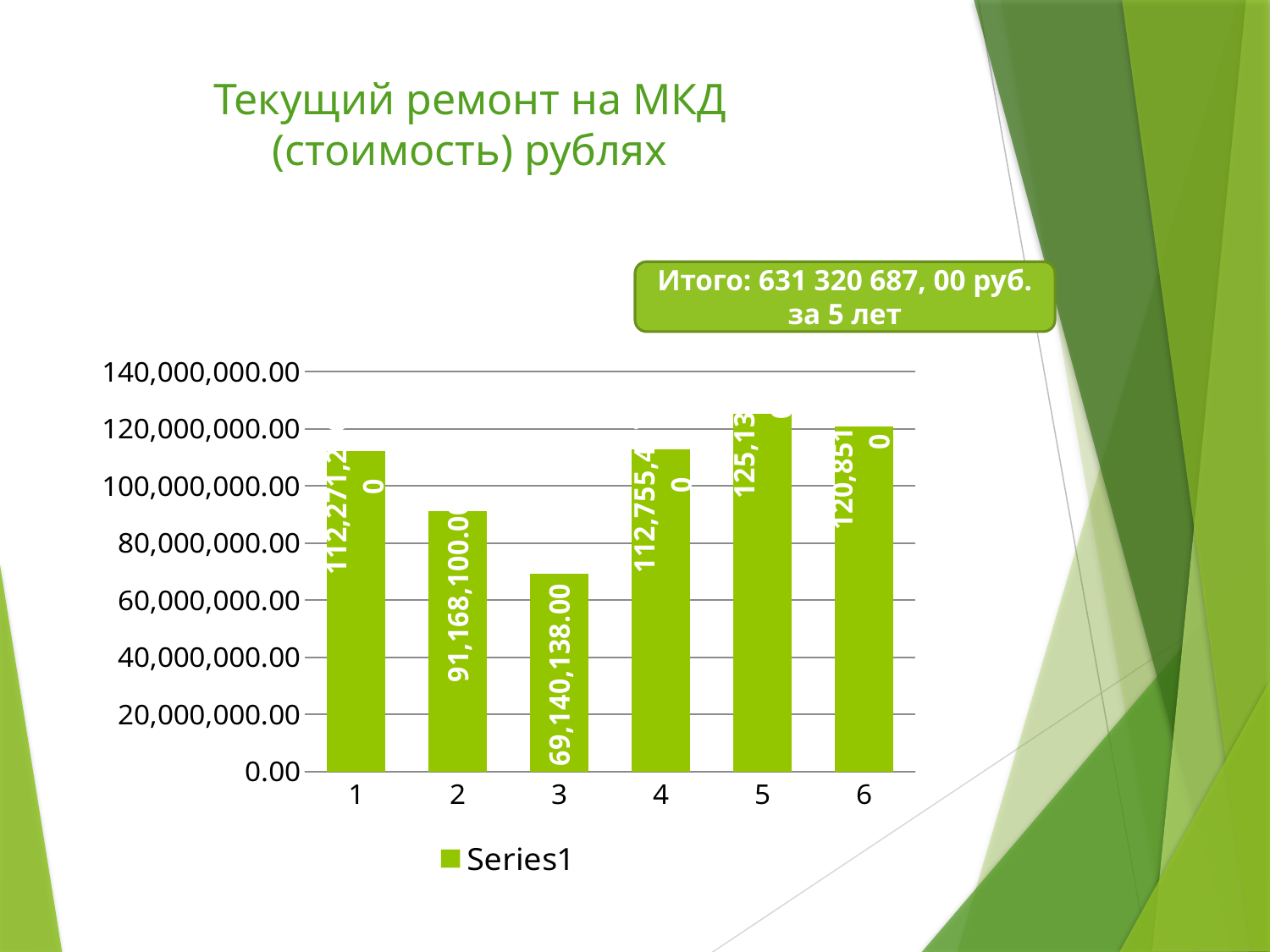
Which is larger, the value for category 3 or category 4? category 4 Is the value for category 3 greater or less than 80,000,000.00? less What type of chart is shown on the slide? bar chart How many categories are plotted on the x axis of the chart? 6 Is the value for category 2 greater or less than 100,000,000.00? less What is the name of the series shown in the chart legend? Series1 Which is larger, the value for category 1 or category 2? category 1 What is the value for category 3? 69,140,138.00 Which category has the lowest value? 3 Which category has the highest value? 5 How many series does the chart legend list? 1 Is the value for category 1 greater or less than 100,000,000.00? greater